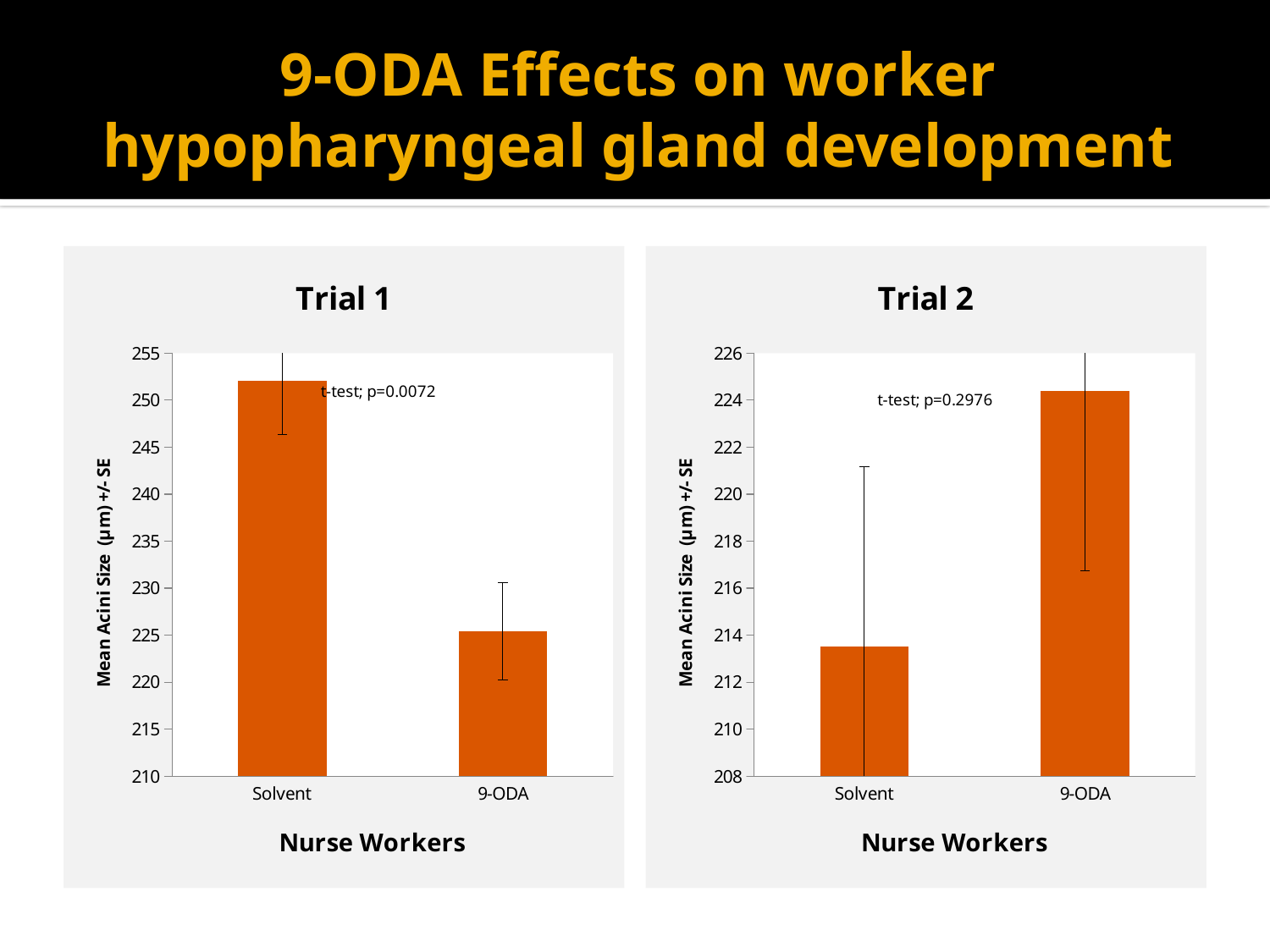
What kind of chart is the Trial 1 chart? bar chart In the Trial 2 chart, which category has the lower mean acini size? Solvent In the Trial 1 chart, which category has the higher mean acini size? Solvent In the Trial 1 chart, is the value for Solvent greater or less than 245? greater What p-value is printed on the Trial 1 chart? p=0.0072 In the Trial 2 chart, which is larger, the value for Solvent or the value for 9-ODA? 9-ODA In the Trial 1 chart, is the value for 9-ODA greater or less than 230? less In the Trial 2 chart, is the value for 9-ODA greater or less than 222? greater How many categories are shown on the x axis of the Trial 1 chart? 2 What is the y-axis label of the Trial 2 chart? Mean Acini Size (µm) +/- SE